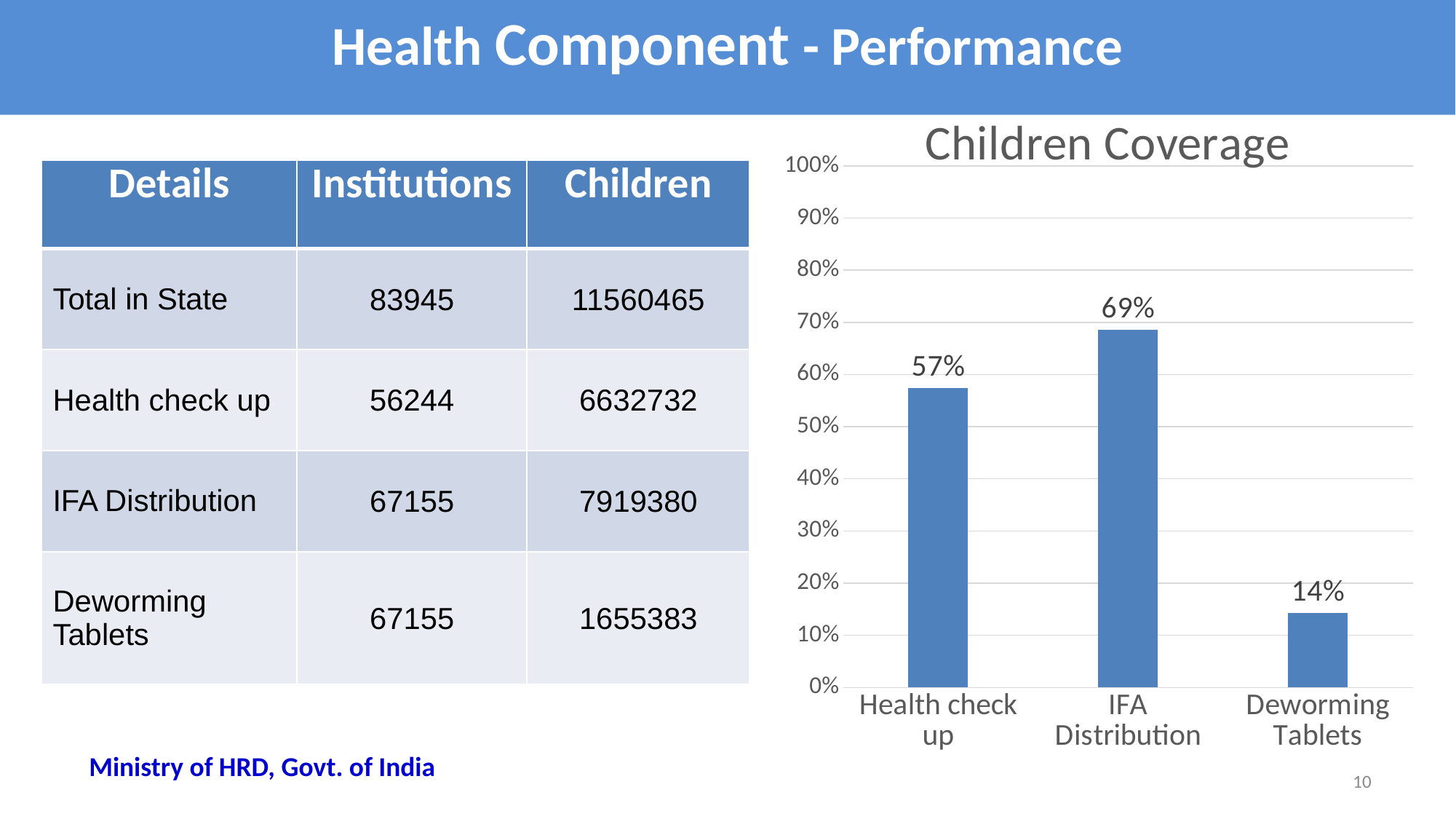
What is the title of the chart on the slide? Children Coverage What kind of chart is the Children Coverage chart? Bar chart What is the difference between the IFA Distribution and Health check up values in the Children Coverage chart? 12% What is the value for Health check up in the Children Coverage chart? 57% Which category has the highest value in the Children Coverage chart? IFA Distribution Is the value for IFA Distribution in the Children Coverage chart greater or less than 60%? greater Which is larger in the Children Coverage chart, Health check up or Deworming Tablets? Health check up What is the value for IFA Distribution in the Children Coverage chart? 69% What is the value for Deworming Tablets in the Children Coverage chart? 14% How many categories are shown in the Children Coverage chart? 3 What is the difference between the Health check up and Deworming Tablets values in the Children Coverage chart? 43% Which category has the lowest value in the Children Coverage chart? Deworming Tablets